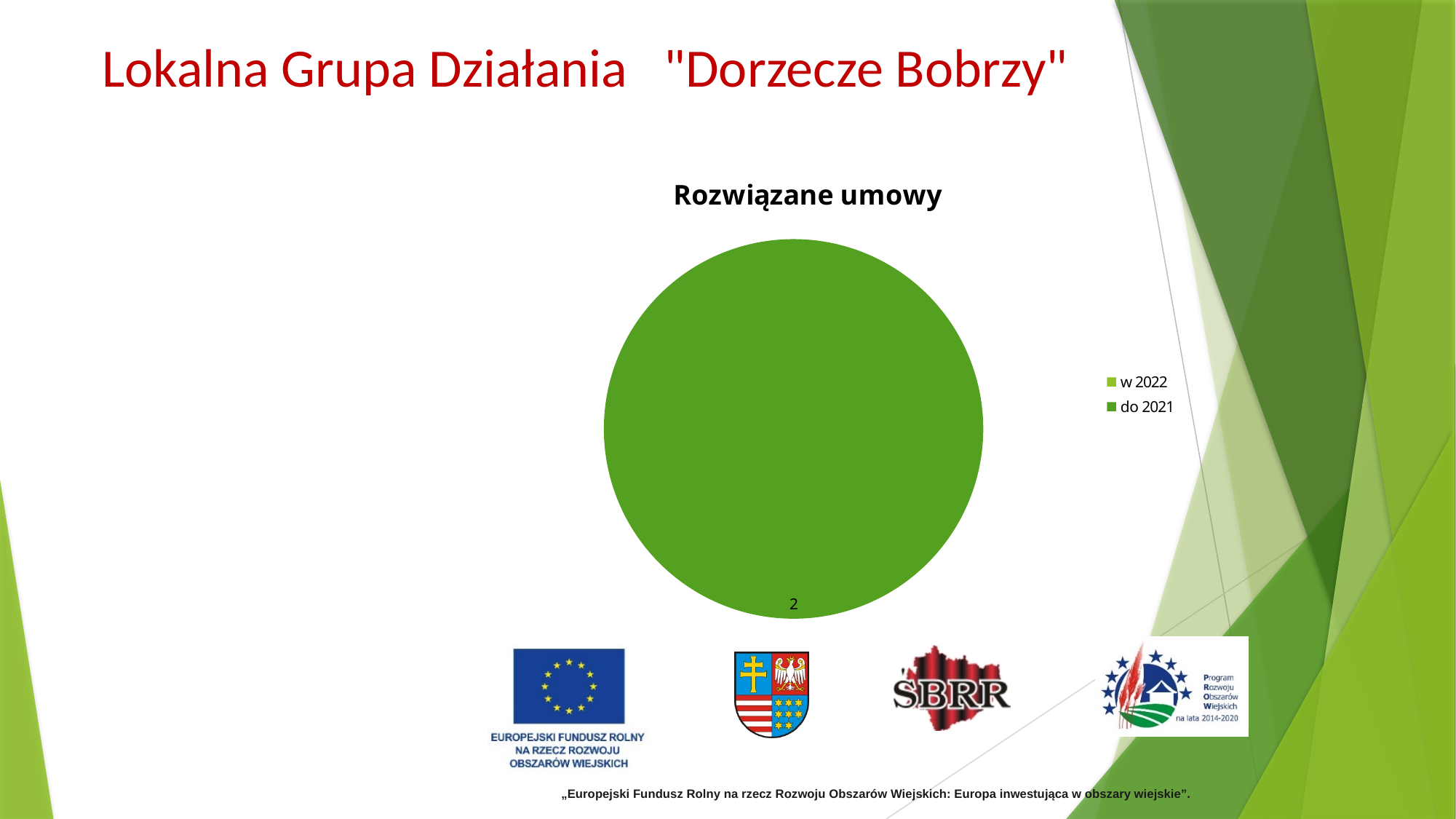
What data label value is printed on the pie chart? 2 What is the title of the chart? Rozwiązane umowy What kind of chart is shown on the slide? pie chart What are the two legend entries of the chart? w 2022, do 2021 How many data labels are printed on the pie chart? 1 How many entries does the chart's legend list? 2 What share of the pie does the single visible slice occupy? 100%